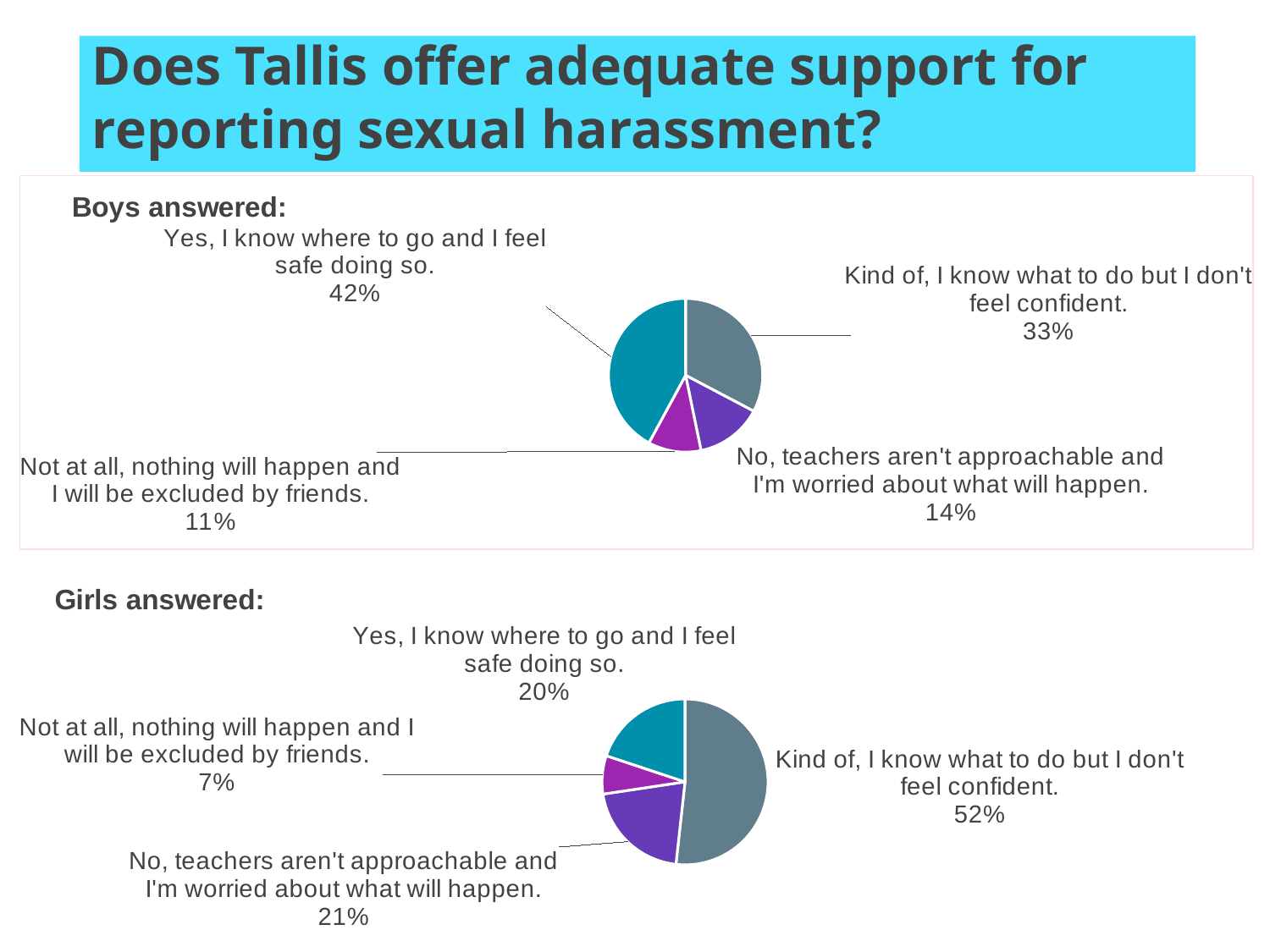
How many pie charts are shown on the slide? 2 How many slices does the 'Boys answered' pie chart have? 4 What is the difference between the boys' and girls' percentages for 'Yes, I know where to go and I feel safe doing so.'? 22% In the 'Girls answered' pie chart, what share answered 'No, teachers aren't approachable and I'm worried about what will happen.'? 21% In the 'Girls answered' pie chart, what percentage answered 'Kind of, I know what to do but I don't feel confident.'? 52% In the 'Girls answered' pie chart, which response has the smallest share? Not at all, nothing will happen and I will be excluded by friends. In the 'Girls answered' pie chart, which is larger: the 'Yes, I know where to go' share or the 'No, teachers aren't approachable' share? No, teachers aren't approachable and I'm worried about what will happen. What type of chart is used for the 'Girls answered' data? Pie chart In the 'Boys answered' pie chart, what is the difference between the 'Kind of' share and the 'No, teachers aren't approachable' share? 19% In the 'Boys answered' pie chart, which response has the largest share? Yes, I know where to go and I feel safe doing so. In the 'Boys answered' pie chart, what percentage answered 'Yes, I know where to go and I feel safe doing so.'? 42% In the 'Boys answered' pie chart, what share answered 'Not at all, nothing will happen and I will be excluded by friends.'? 11%